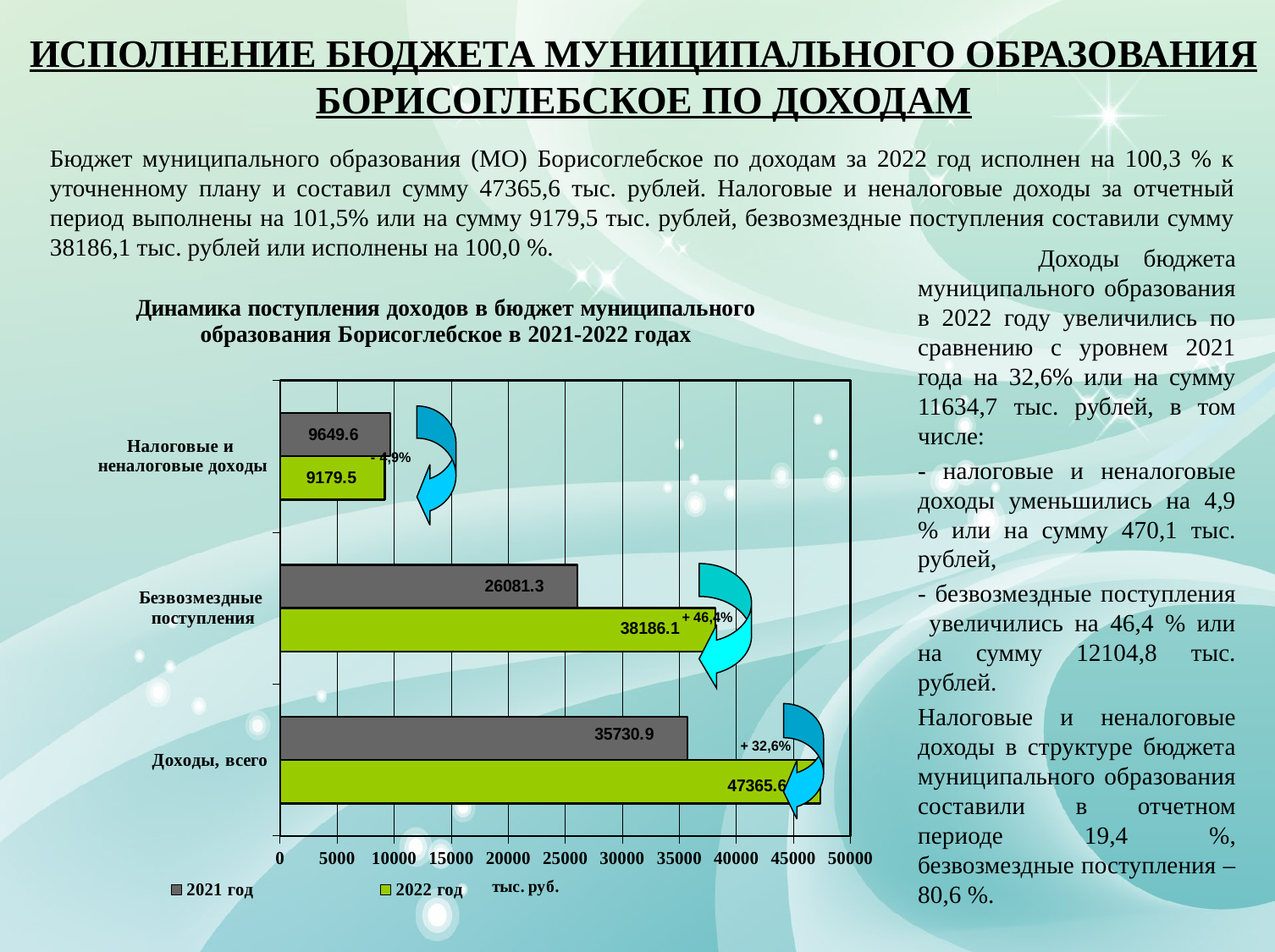
How many categories are shown on the chart? 3 What is the value for 2022 год for Налоговые и неналоговые доходы? 9179.5 What is the difference between the 2022 год and 2021 год values for Безвозмездные поступления? 12104.8 What type of chart is shown on the slide? Bar chart What is the difference between the 2022 год and 2021 год values for Доходы, всего? 11634.7 Which category has the highest value for 2022 год? Доходы, всего What is the value for 2021 год for Безвозмездные поступления? 26081.3 What is the value for 2021 год for Доходы, всего? 35730.9 Which category has the lowest value for 2021 год? Налоговые и неналоговые доходы How many series does the legend list? 2 What is the value for 2022 год for Доходы, всего? 47365.6 Which is larger for Налоговые и неналоговые доходы: the 2021 год value or the 2022 год value? 2021 год